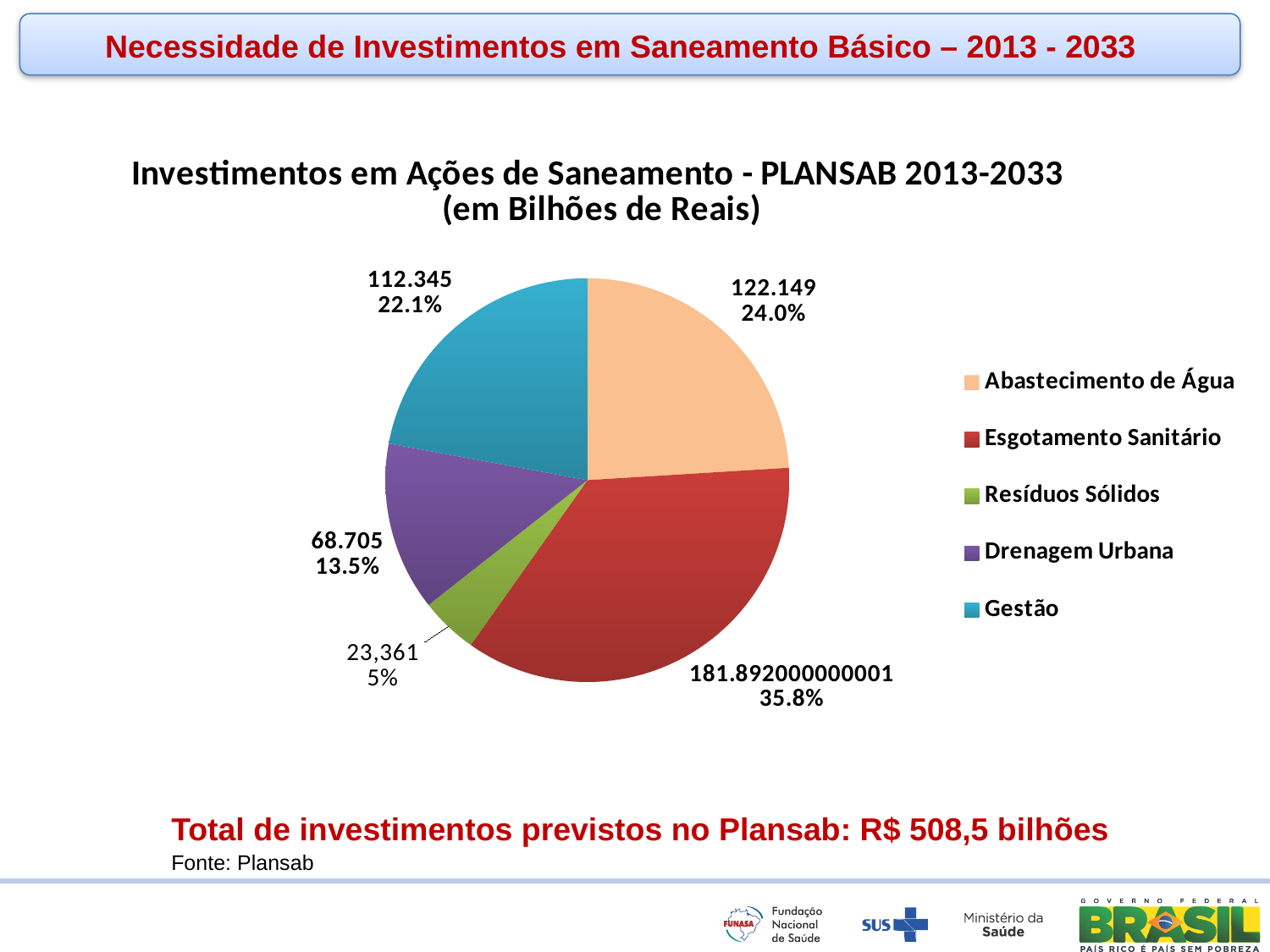
Which category has the smallest slice of the pie? Resíduos Sólidos How many entries does the legend list? 5 What is the value shown for Drenagem Urbana? 68.705 Which category has the largest slice of the pie? Esgotamento Sanitário Which is larger, the value for Abastecimento de Água or the value for Gestão? Abastecimento de Água What is the value shown for Gestão? 112.345 What is the difference between the values for Abastecimento de Água and Gestão? 9.804 What is the value shown for Abastecimento de Água? 122.149 How many slices does the pie chart have? 5 What kind of chart is shown on the slide? pie chart What share of the pie does Esgotamento Sanitário represent? 35.8% What share of the pie does Resíduos Sólidos represent? 5%